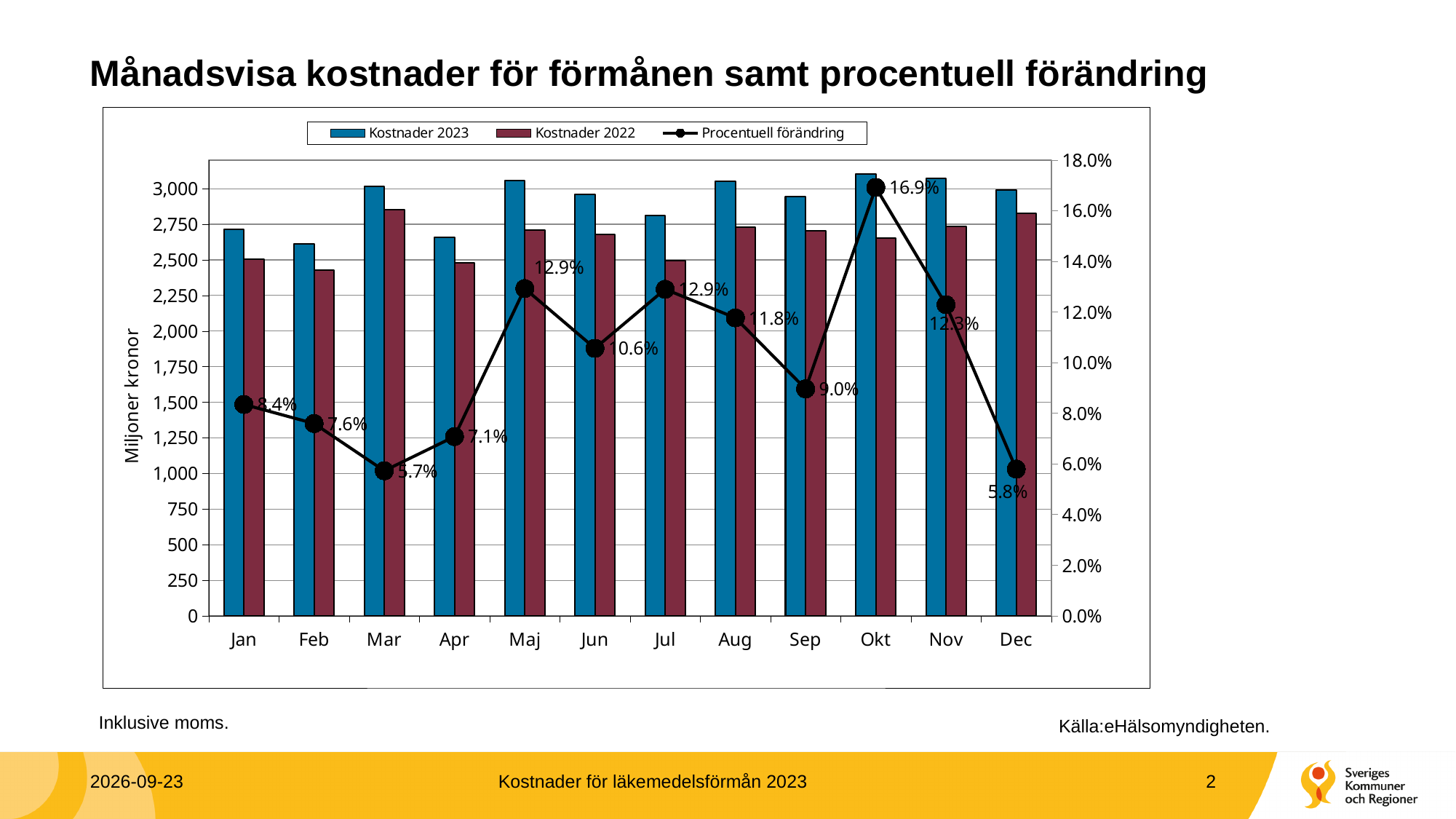
What is the Procentuell förändring value for Okt? 16.9% Is the Kostnader 2023 value for Jan greater or less than 2,500? greater How many series does the legend list? 3 What is the Procentuell förändring value for Mar? 5.7% Which month has the highest Procentuell förändring? Okt Is the Kostnader 2022 value for Feb greater or less than 2,500? less What is the Procentuell förändring value for Jun? 10.6% Which month has the lowest Procentuell förändring? Mar How many months are shown on the x axis? 12 What is the label of the left vertical axis? Miljoner kronor What is the difference in Procentuell förändring between Okt and Mar? 11.2 percentage points Is the Procentuell förändring higher in Aug or in Sep? Aug